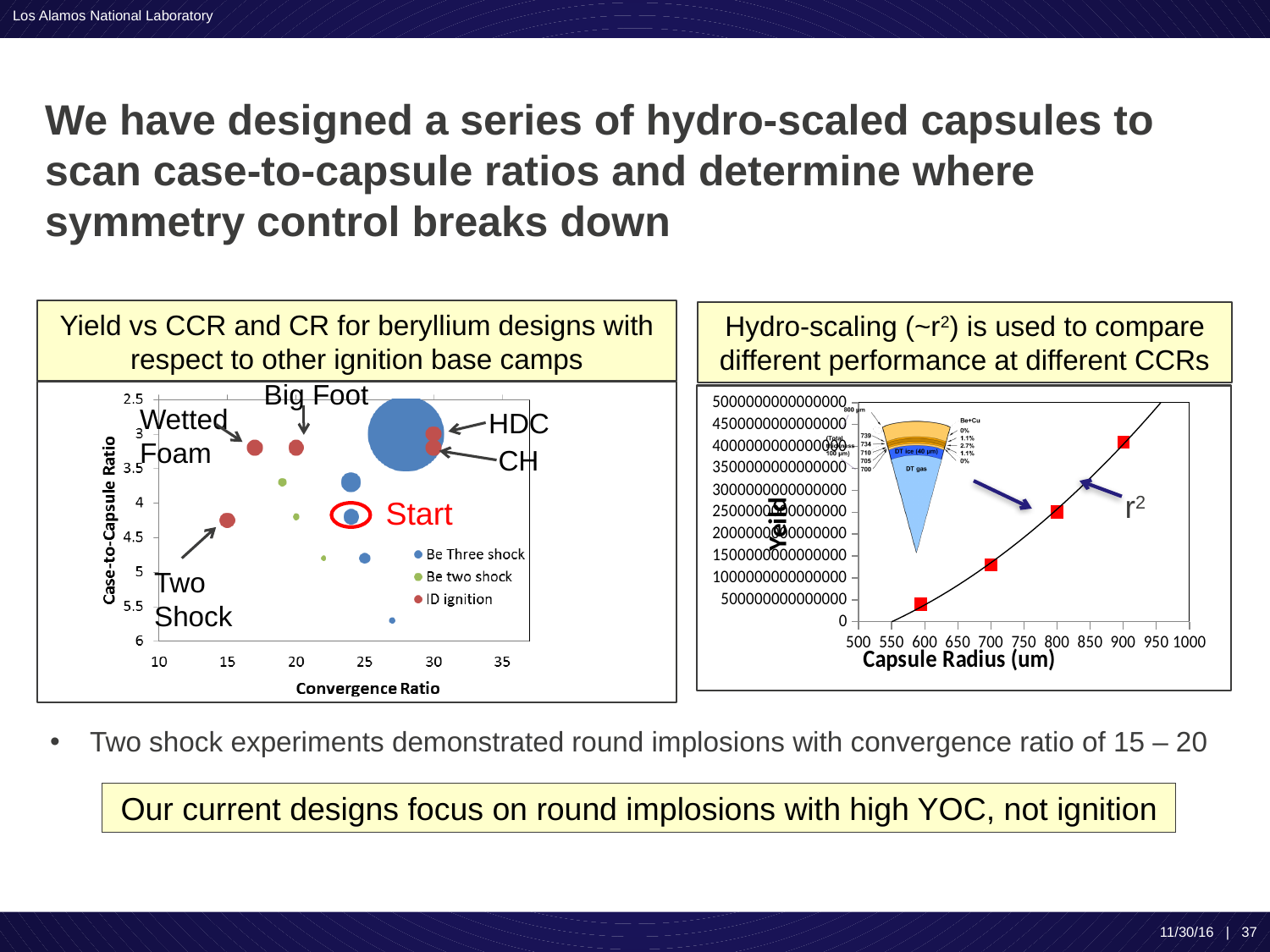
On the left chart, is the convergence ratio of the point labelled 'HDC' greater or less than 25? greater On the right chart, how many red square data points are plotted? 4 On the right chart, is the yield at a capsule radius of 900 greater or less than 3000000000000000? greater On the right chart, is the yield at a capsule radius of 600 greater or less than 1000000000000000? less On the right chart, what is the label of the x axis? Capsule Radius (um) On the right chart, does the yield rise or fall as capsule radius increases? rise On the left chart, how many series does the legend list? 3 On the left chart, which has the larger convergence ratio, the 'Two Shock' point or the 'HDC' point? HDC On the left chart, what is the label of the x axis? Convergence Ratio On the left chart, what is the label of the y axis? Case-to-Capsule Ratio